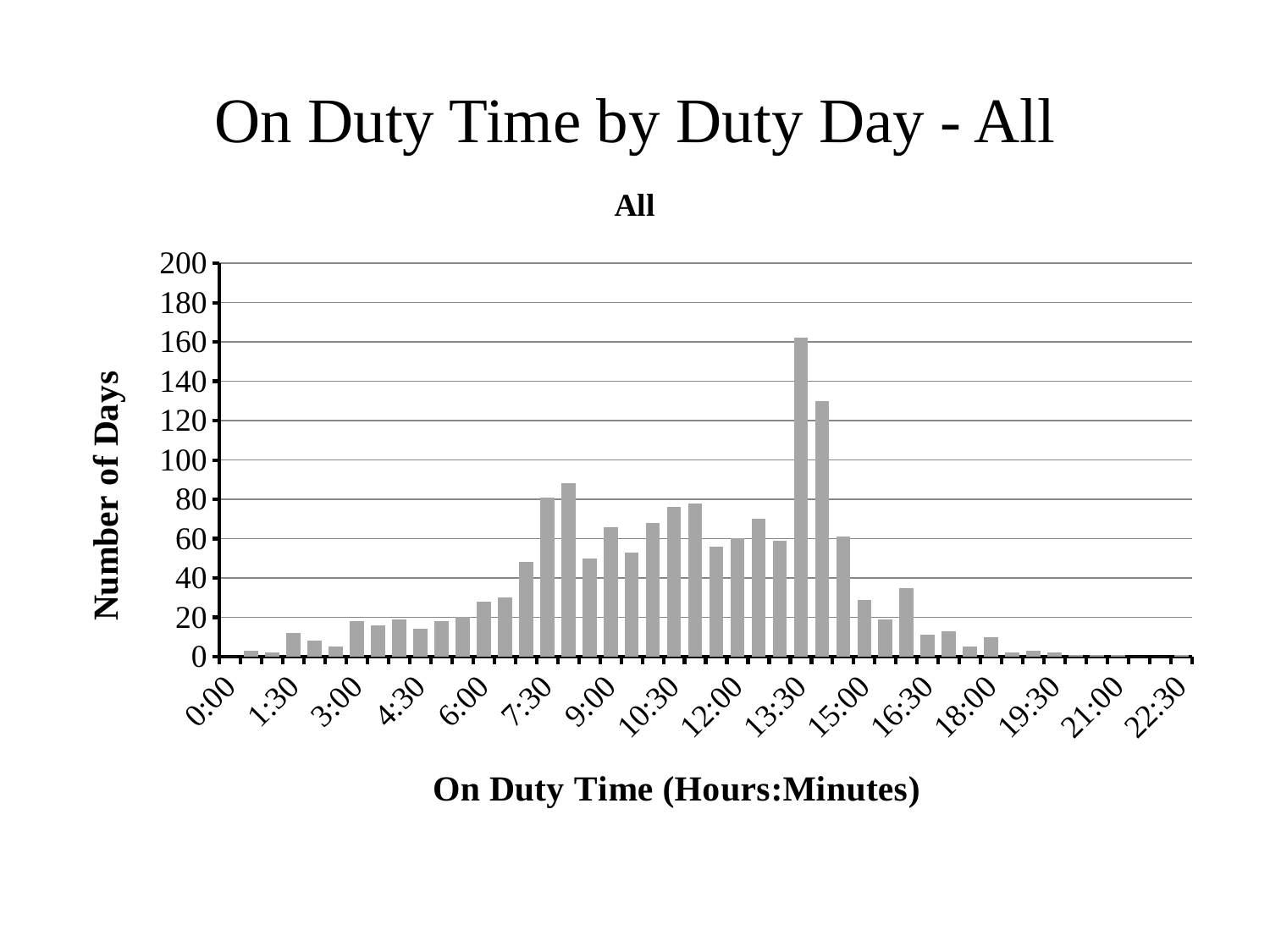
Is the number of days for 6:00 greater or less than 40? less Which has more days, 13:30 or 15:00? 13:30 Which on duty time has the highest number of days? 13:30 What is the title of the x axis? On Duty Time (Hours:Minutes) What kind of chart is shown on the slide? bar chart Is the number of days for 10:30 greater or less than 60? greater What is the title of the y axis? Number of Days Is the number of days for 13:30 greater or less than 140? greater Which has more days, 7:30 or 6:00? 7:30